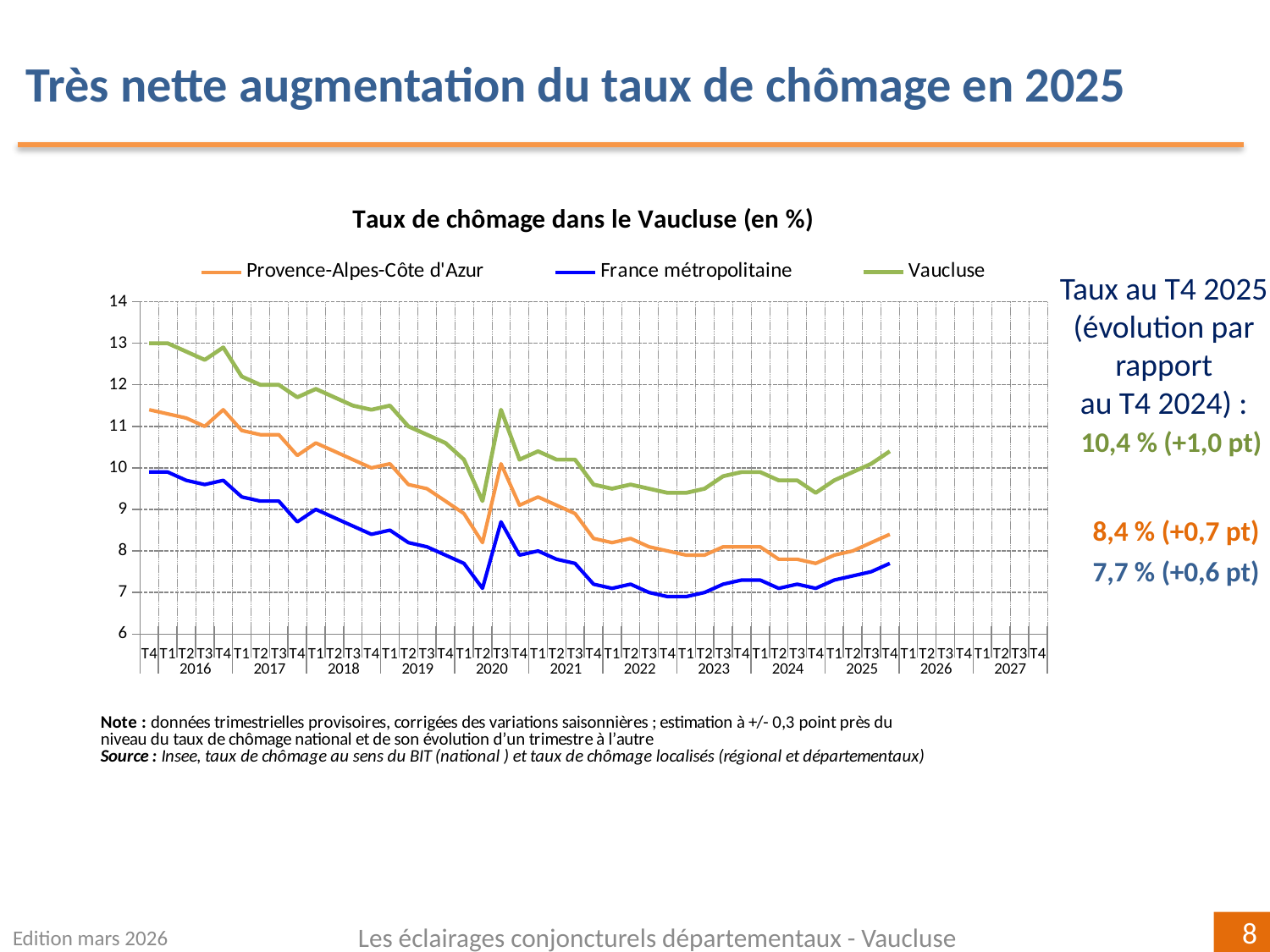
Does the Vaucluse series rise or fall between T4 2015 and T4 2019? fall By how many points did the Vaucluse unemployment rate change between T4 2024 and T4 2025? +1,0 pt What is the difference between the Vaucluse rate and the France métropolitaine rate at T4 2025? 2,7 points Is the value for Vaucluse at T4 2015 greater or less than 12? greater What kind of chart is shown on the slide? line chart At T4 2025, which is higher: Provence-Alpes-Côte d'Azur or France métropolitaine? Provence-Alpes-Côte d'Azur Which series has the highest value at T4 2025? Vaucluse What is the title of the chart? Taux de chômage dans le Vaucluse (en %) How many series does the legend of the chart list? 3 What is the unemployment rate for Vaucluse at T4 2025? 10,4 % What is the unemployment rate for France métropolitaine at T4 2025? 7,7 % What is the unemployment rate for Provence-Alpes-Côte d'Azur at T4 2025? 8,4 %